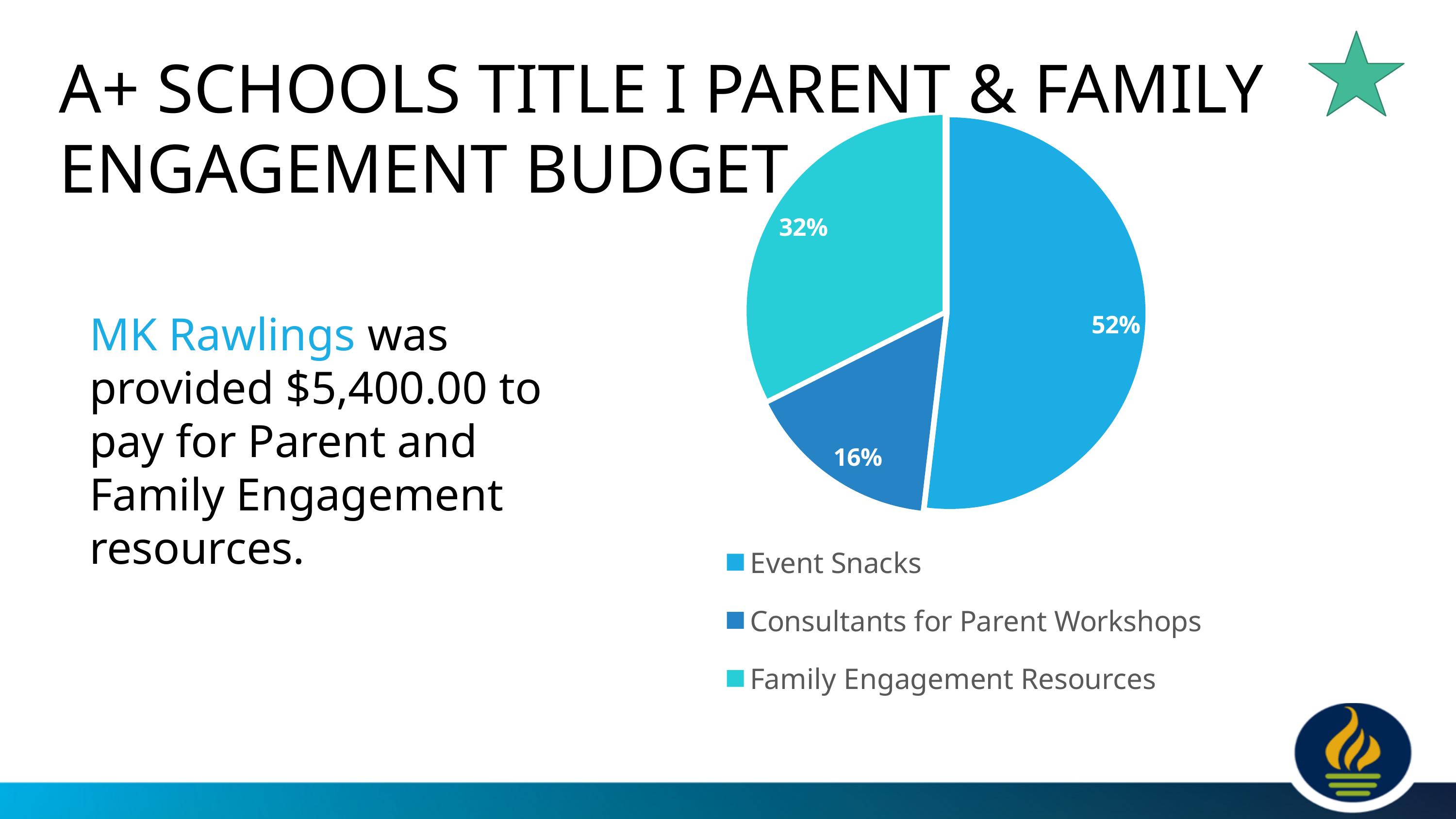
Which legend entry is shown in the darkest blue colour? Consultants for Parent Workshops What share of the pie does Consultants for Parent Workshops take? 16% Which category has the largest slice of the pie? Event Snacks Which category has the smallest slice of the pie? Consultants for Parent Workshops What is the difference in percentage points between Family Engagement Resources and Consultants for Parent Workshops? 16 How many categories does the pie chart show? 3 Which is larger, the slice for Family Engagement Resources or the slice for Consultants for Parent Workshops? Family Engagement Resources What share of the pie does Event Snacks take? 52% Is the share for Event Snacks greater or less than 50%? greater What kind of chart is shown on the slide? pie chart What share of the pie does Family Engagement Resources take? 32% What is the difference in percentage points between Event Snacks and Family Engagement Resources? 20